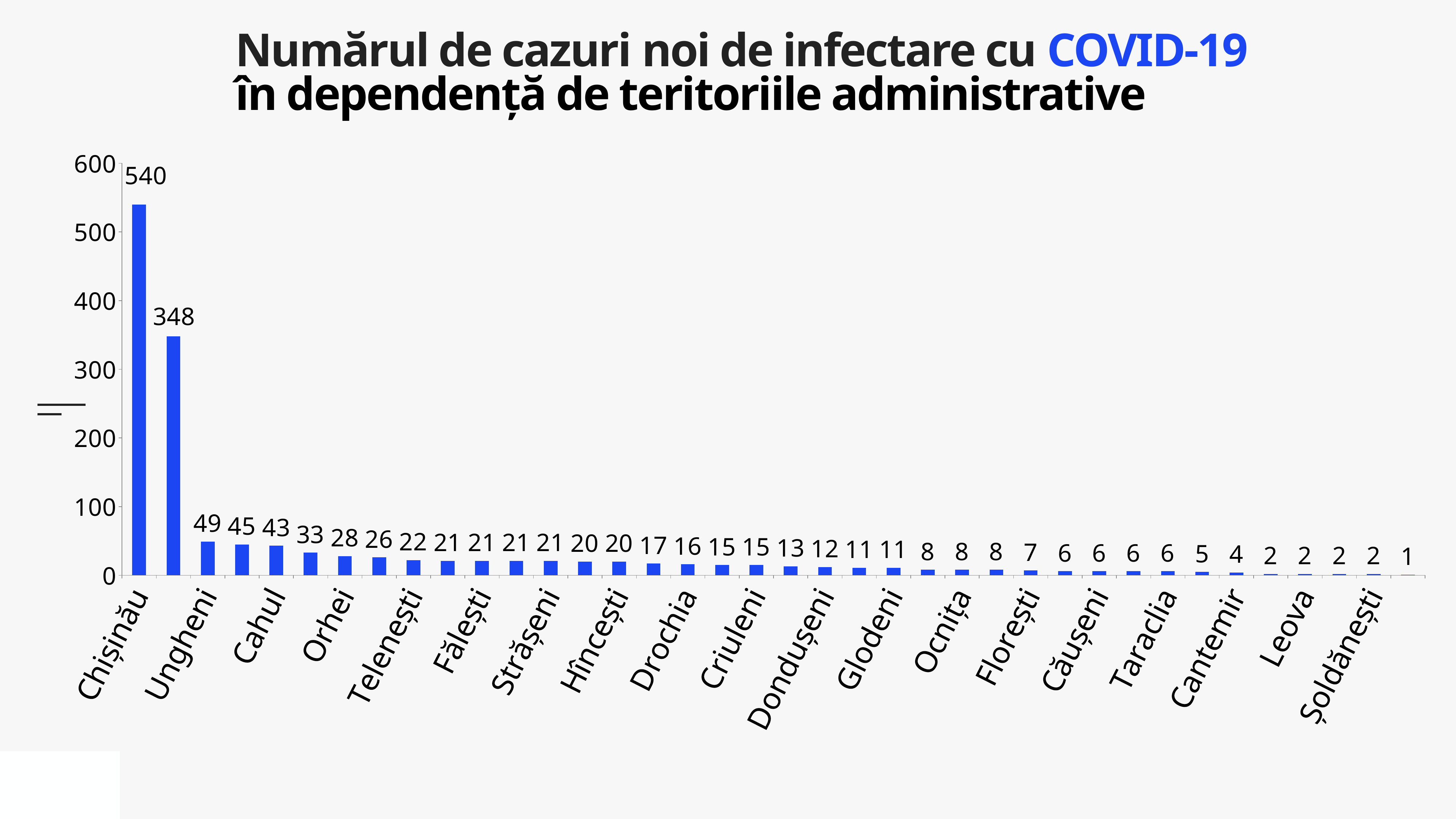
Do the values rise or fall moving from left to right along the x axis? fall What is the smallest value shown on any bar in the chart? 1 Is the value for Chișinău greater or less than 500? greater What is the highest tick value shown on the y axis? 600 What is the difference between the two tallest bars (540 and 348)? 192 How many bars are plotted in the chart? 38 Which administrative territory has the highest number of new COVID-19 cases? Chișinău What is the value of the second-tallest bar in the chart? 348 What is the number of new COVID-19 cases for Chișinău? 540 What is the number of new COVID-19 cases for Ungheni? 49 Which is larger, the value for Chișinău or the value for Ungheni? Chișinău What type of chart is shown on the slide? bar chart